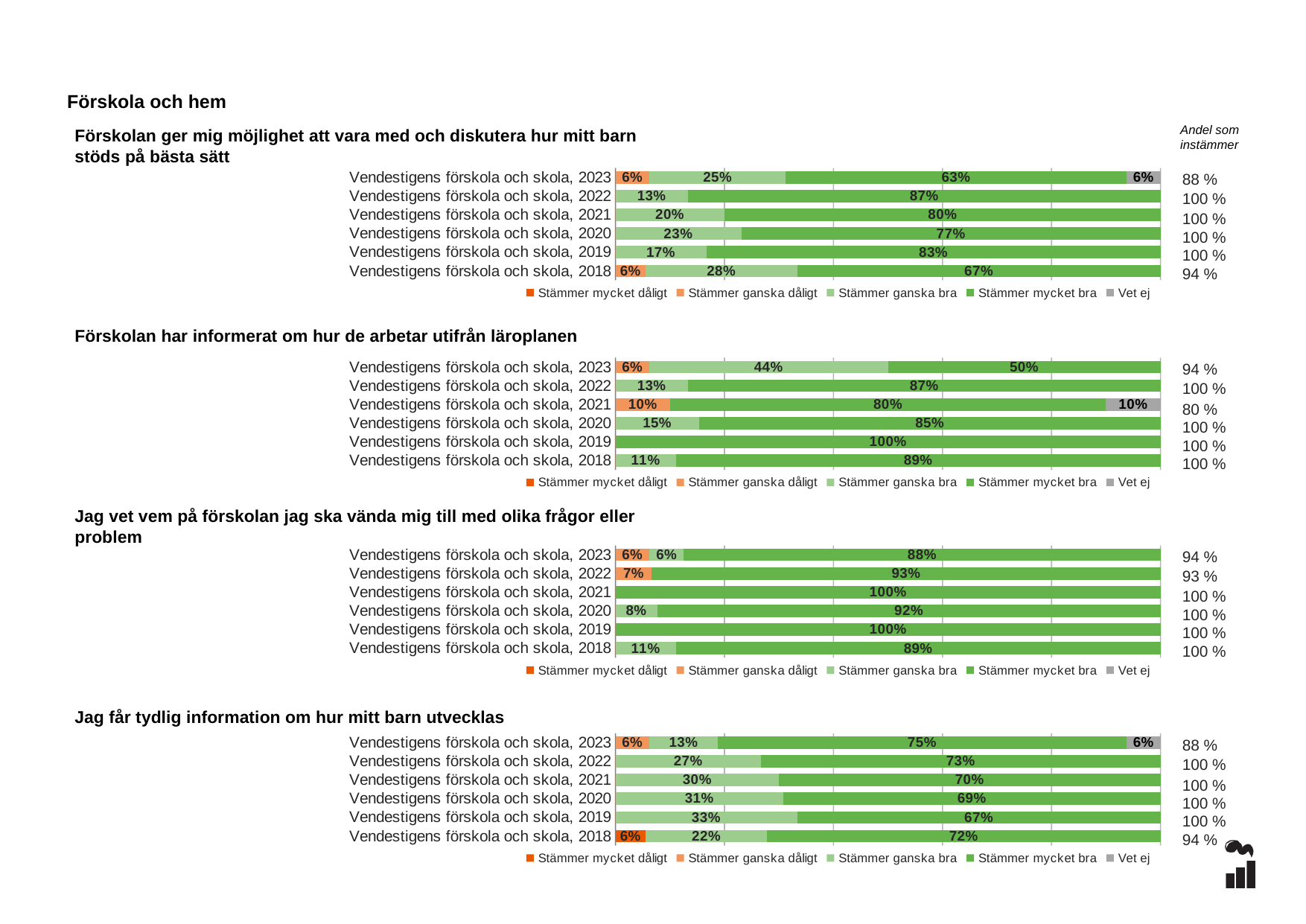
What kind of chart is 'Förskolan har informerat om hur de arbetar utifrån läroplanen'? Stacked bar chart In the chart 'Jag får tydlig information om hur mitt barn utvecklas', is the 'Stämmer ganska bra' value larger for 2019 or 2022? 2019 In the chart 'Förskolan har informerat om hur de arbetar utifrån läroplanen', which year has the highest 'Stämmer mycket bra' value? 2019 In the chart 'Förskolan har informerat om hur de arbetar utifrån läroplanen', what is the 'Vet ej' value for 2021? 10% In the chart 'Jag vet vem på förskolan jag ska vända mig till med olika frågor eller problem', what is the difference between the 'Stämmer mycket bra' values for 2022 and 2018? 4% In the chart 'Förskolan ger mig möjlighet att vara med och diskutera hur mitt barn stöds på bästa sätt', which year has the lowest 'Stämmer mycket bra' value? 2023 How many series does the legend list for the chart 'Jag får tydlig information om hur mitt barn utvecklas'? 5 In the chart 'Jag får tydlig information om hur mitt barn utvecklas', what is the 'Stämmer mycket bra' value for 2023? 75% In the chart 'Förskolan ger mig möjlighet att vara med och diskutera hur mitt barn stöds på bästa sätt', what is the 'Stämmer mycket bra' value for Vendestigens förskola och skola, 2022? 87% In the chart 'Jag vet vem på förskolan jag ska vända mig till med olika frågor eller problem', what is the 'Stämmer ganska dåligt' value for 2022? 7% In the chart 'Förskolan har informerat om hur de arbetar utifrån läroplanen', what is the 'Stämmer ganska bra' value for 2023? 44% In the chart 'Förskolan ger mig möjlighet att vara med och diskutera hur mitt barn stöds på bästa sätt', what is the 'Andel som instämmer' for 2018? 94 %